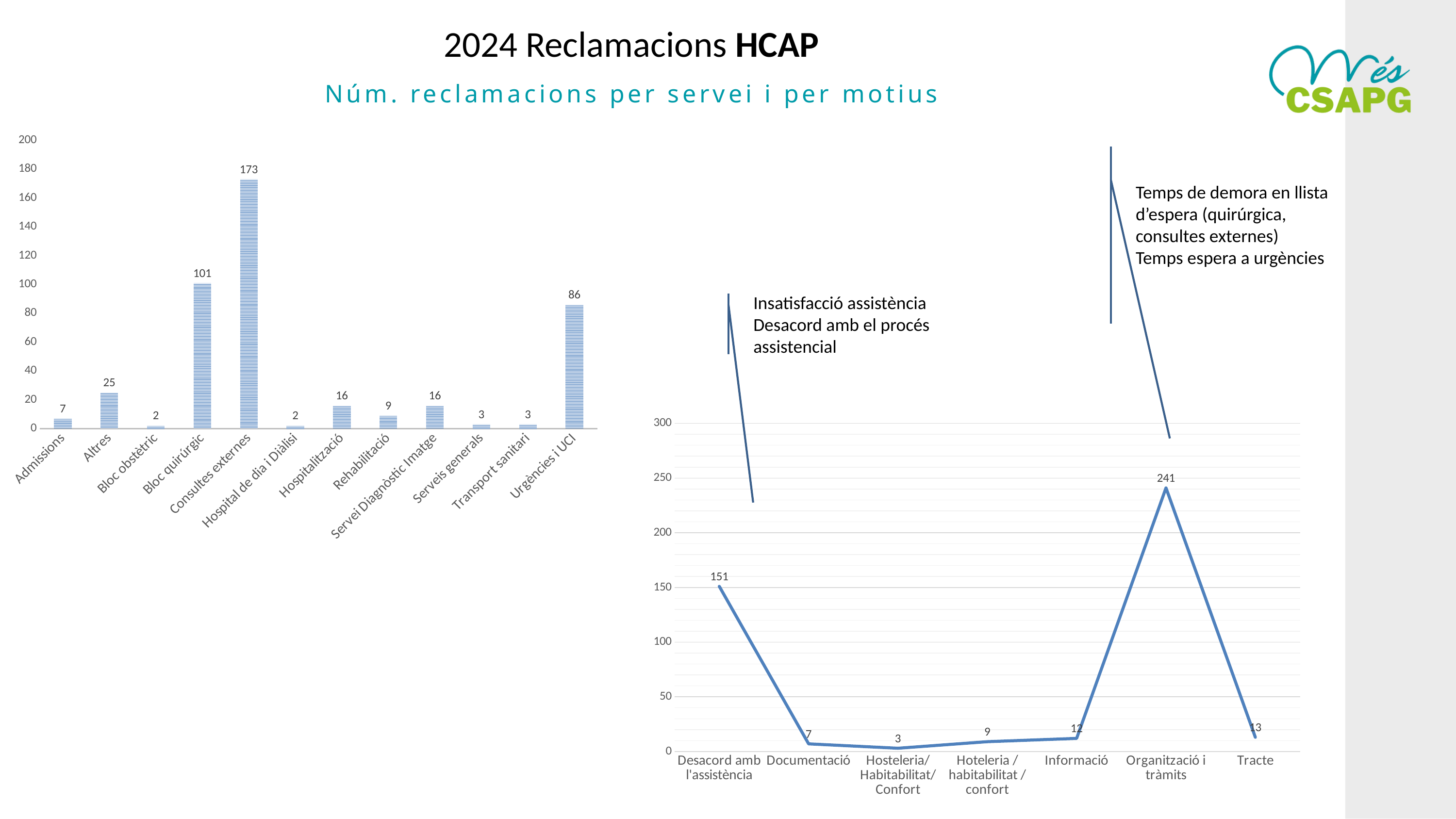
In the bar chart on the left, which category has the highest value? Consultes externes In the line chart on the right, how many data points are plotted? 7 In the bar chart on the left, what is the value for Urgències i UCI? 86 In the bar chart on the left, how many categories are shown on the x axis? 12 In the line chart on the right, which category has the lowest value? Hosteleria/Habitabilitat/Confort In the line chart on the right, what is the difference between Organització i tràmits and Tracte? 228 What kind of chart is the chart on the left? Bar chart In the line chart on the right, what is the value for Desacord amb l'assistència? 151 In the bar chart on the left, which is larger, Altres or Hospitalització? Altres In the bar chart on the left, what is the value for Consultes externes? 173 In the bar chart on the left, what is the difference between Consultes externes and Bloc quirúrgic? 72 In the line chart on the right, what is the value for Organització i tràmits? 241